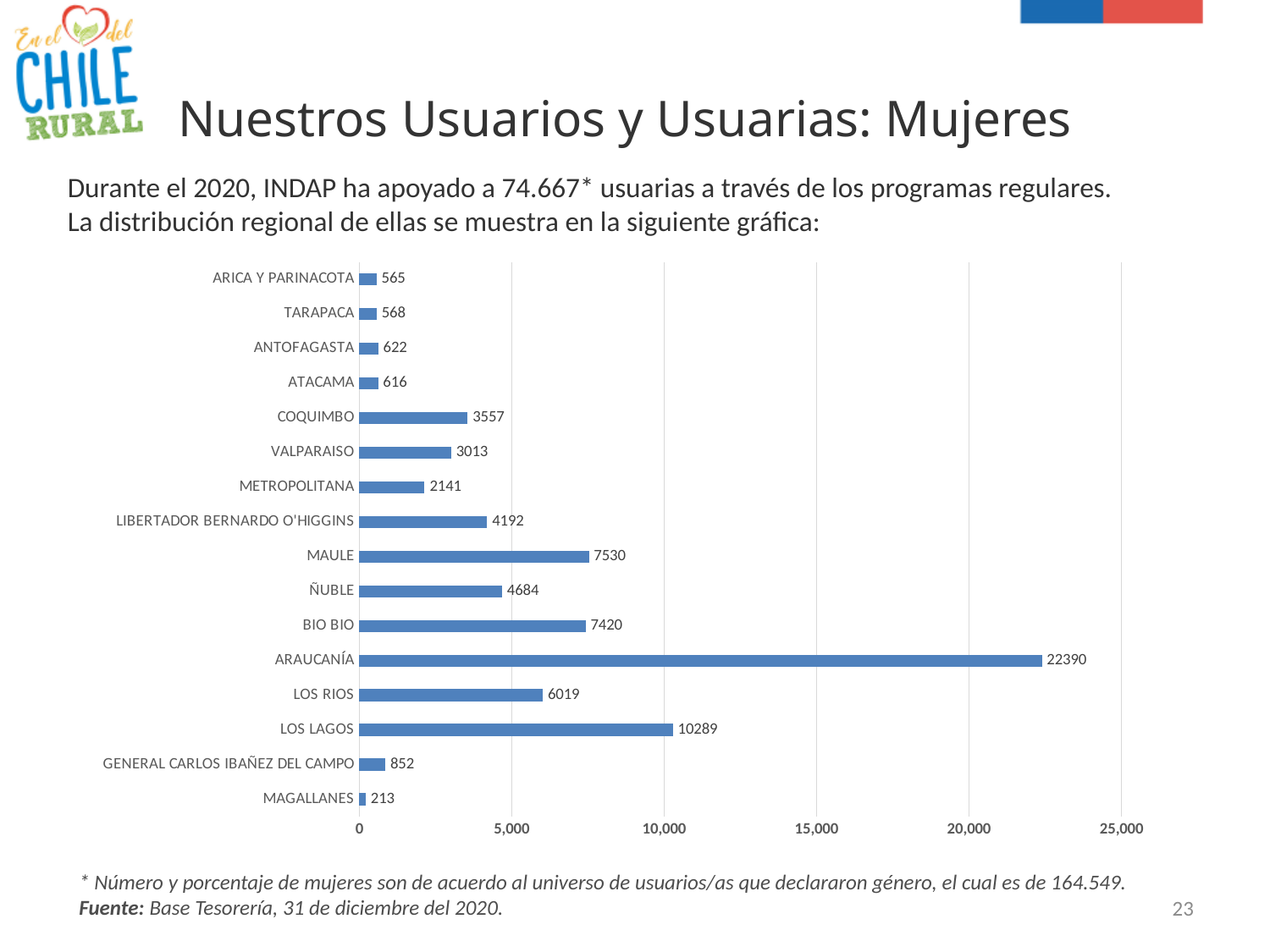
What is the value for MAGALLANES? 213 What is the difference between the values for MAULE and BIO BIO? 110 Is the value for LOS RIOS greater or less than 5,000? greater Which region has the lowest value? MAGALLANES What is the value for LOS LAGOS? 10289 What is the maximum value shown on the horizontal axis? 25,000 What is the value for ARAUCANÍA? 22390 What kind of chart is shown on the slide? bar chart What is the difference between the values for ARAUCANÍA and LOS LAGOS? 12101 Which region has the highest value? ARAUCANÍA How many regions are shown in the chart? 16 Which is larger, the value for COQUIMBO or the value for VALPARAISO? COQUIMBO